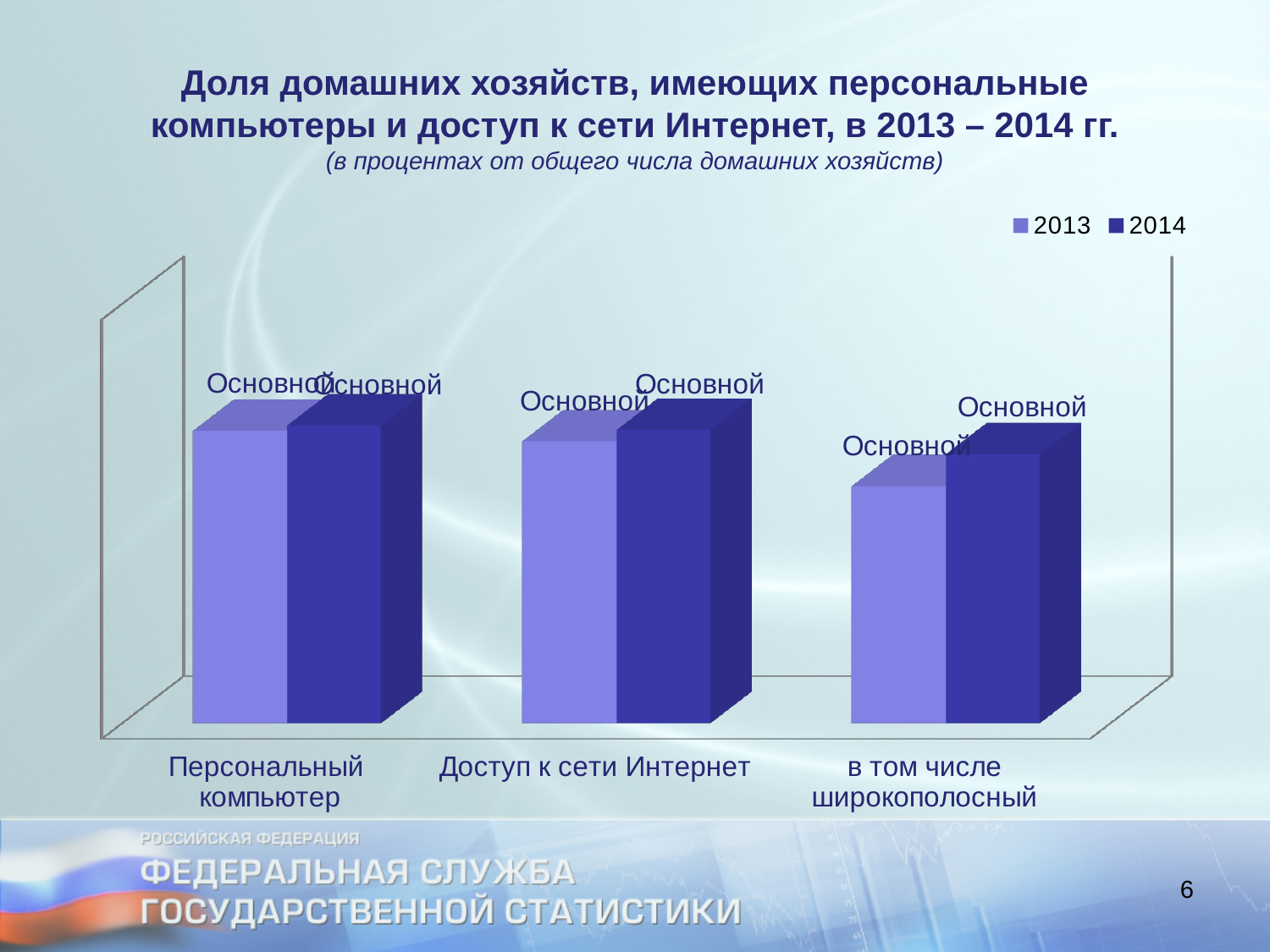
Which series is drawn in the darker blue colour? 2014 For 'Доступ к сети Интернет', which is larger: the 2013 value or the 2014 value? 2014 Which series are listed in the chart legend? 2013 and 2014 What kind of chart is shown on the slide? bar chart How many series does the legend list? 2 How many categories are shown on the x axis of the chart? 3 Do the 2014 values rise or fall from left to right across the categories? fall Which category has the highest value for 2013? Персональный компьютер Which category has the lowest value for 2014? в том числе широкополосный Which category has the lowest value for 2013? в том числе широкополосный For 'в том числе широкополосный', which is larger: the 2013 value or the 2014 value? 2014 Do the 2013 values rise or fall from left to right across the categories? fall